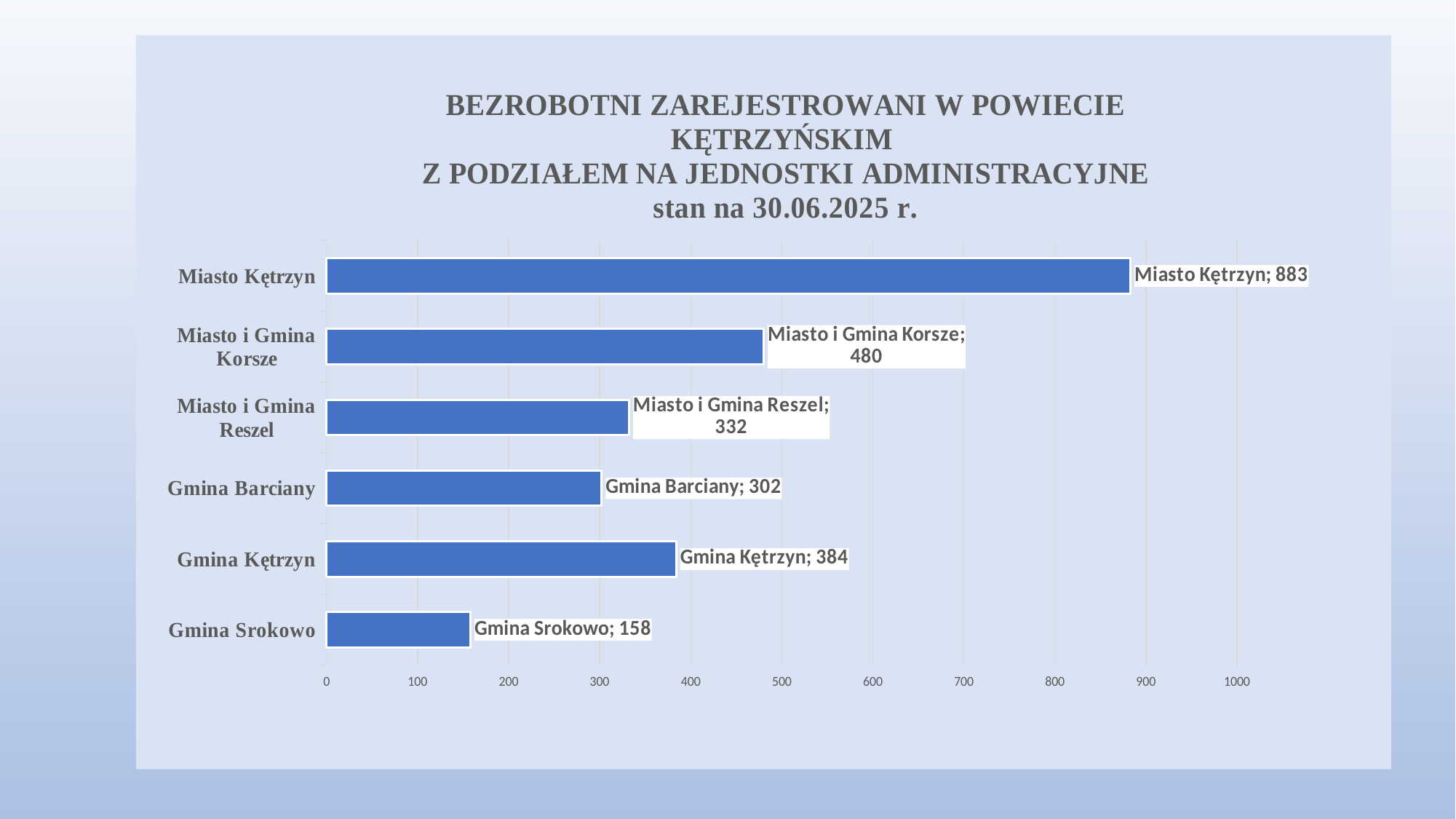
Is the value for Miasto i Gmina Korsze greater or less than 400? greater Which is larger, the value for Gmina Kętrzyn or the value for Miasto i Gmina Reszel? Gmina Kętrzyn What kind of chart is shown on the slide? bar chart Which category has the highest value? Miasto Kętrzyn Which category has the lowest value? Gmina Srokowo What is the difference between the values for Gmina Kętrzyn and Gmina Barciany? 82 What is the value for Miasto i Gmina Reszel? 332 What is the value for Miasto Kętrzyn? 883 How many categories are shown in the chart? 6 What is the value for Gmina Srokowo? 158 What is the difference between the values for Miasto Kętrzyn and Miasto i Gmina Korsze? 403 What date is given in the chart title? 30.06.2025 r.